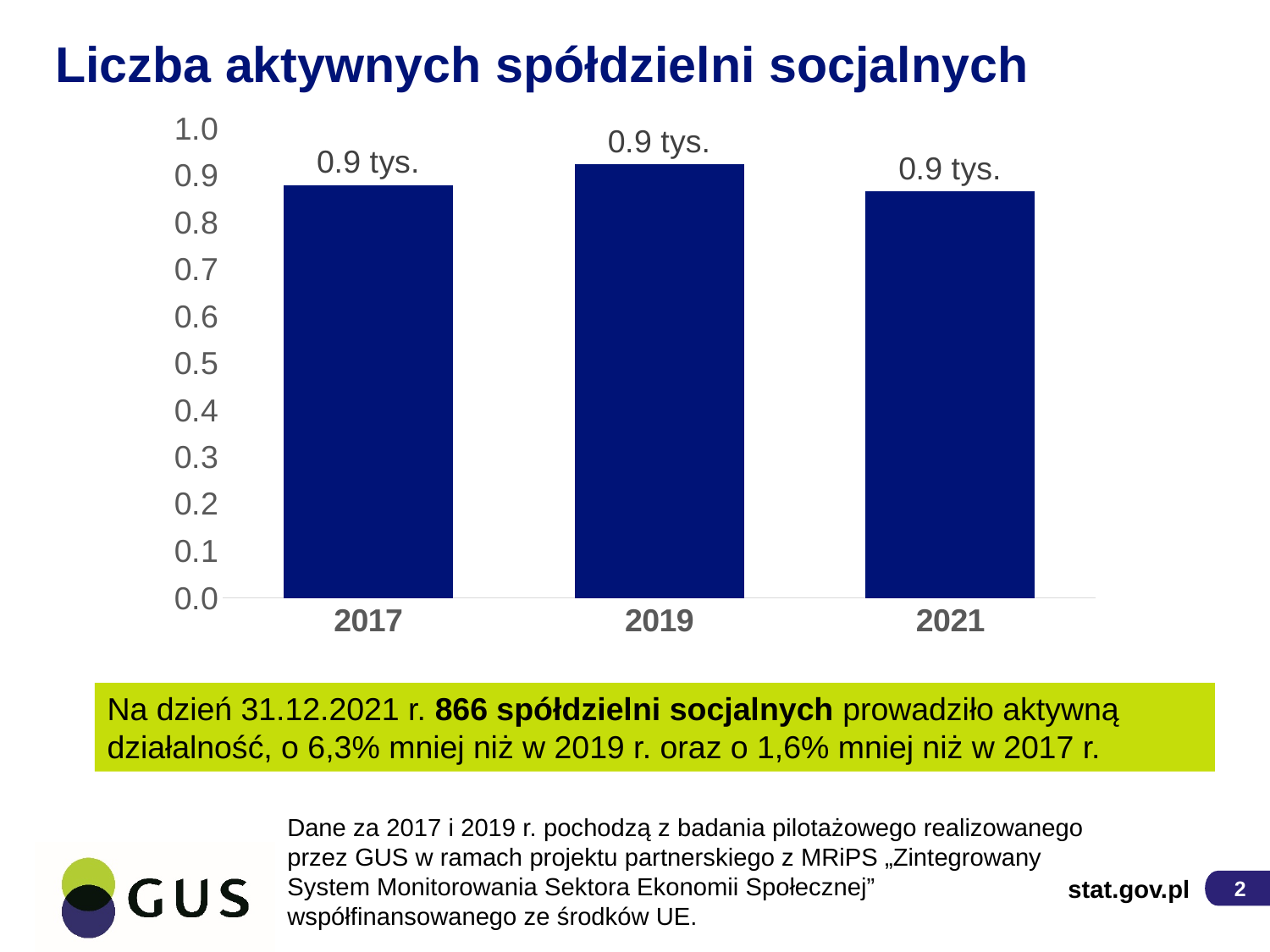
Does the value rise or fall from 2019 to 2021? fall Which year has the tallest bar? 2019 What is the data label shown for 2021? 0.9 tys. What is the data label shown for 2019? 0.9 tys. What is the title of the chart? Liczba aktywnych spółdzielni socjalnych What colour are the bars in the chart? dark blue Is the value for 2021 greater or less than 0.8? greater Which bar is taller, 2019 or 2021? 2019 What kind of chart is shown on the slide? bar chart How many years (bars) are shown in the chart? 3 What is the data label shown for 2017? 0.9 tys. Is the value for 2019 greater or less than 1.0? less